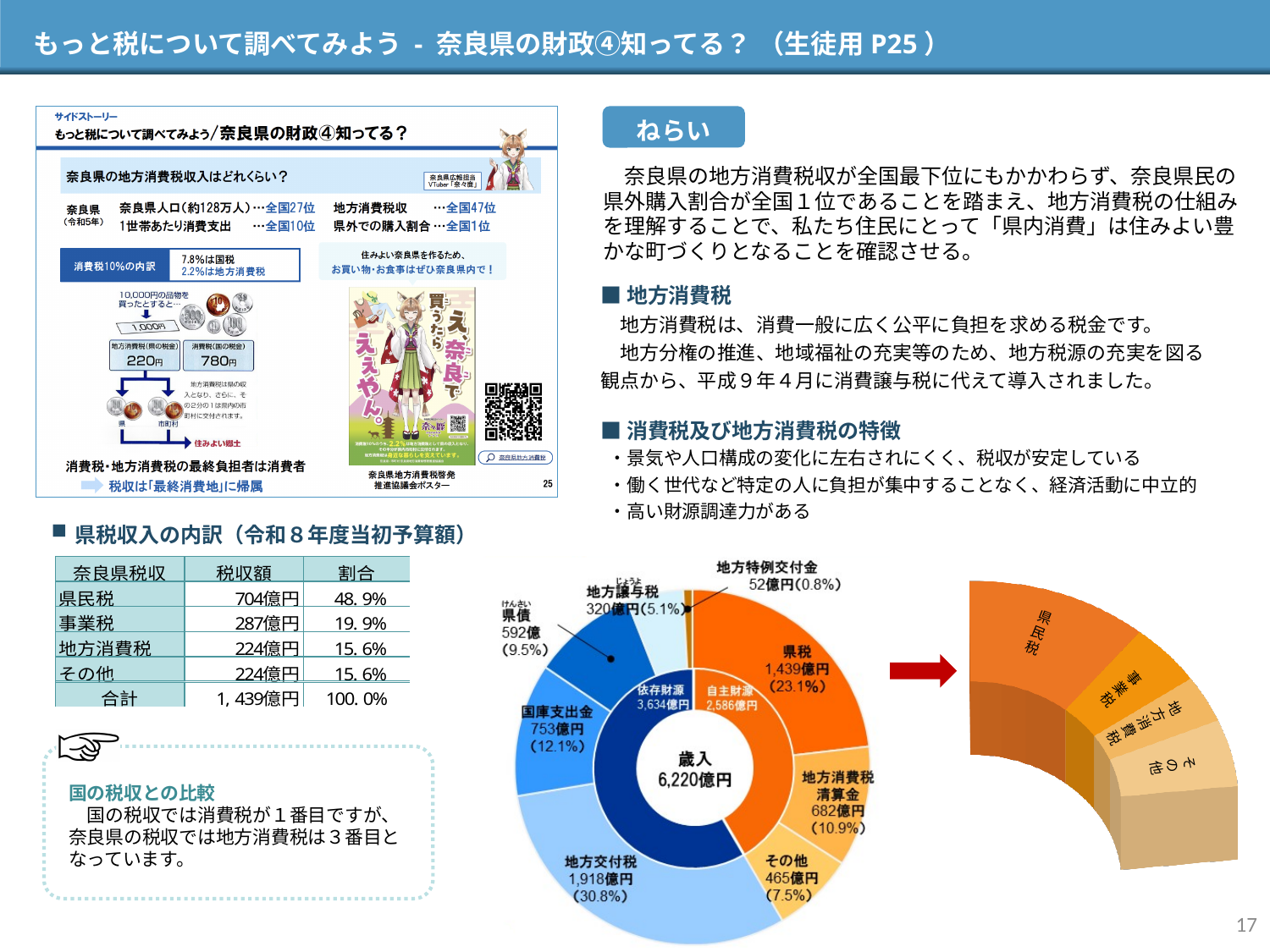
In the 歳入 donut chart, what is the difference between 県税 and 地方消費税清算金? 757億円 In the 歳入 donut chart, what percentage share is shown for 県税? 23.1% In the 歳入 donut chart, what is the value for 国庫支出金? 753億円 How many categories are labelled on the 3D arc chart at the lower right of the slide? 4 In the 歳入 donut chart, which is larger, 国庫支出金 or 県債? 国庫支出金 How many outer segments does the 歳入 donut chart have? 8 In the 歳入 donut chart, what total amount is shown in the centre? 6,220億円 In the 歳入 donut chart, which segment is the largest? 地方交付税 In the 歳入 donut chart, what is the value for 地方交付税? 1,918億円 What kind of chart is the 歳入 chart in the lower centre of the slide? donut chart In the 歳入 donut chart, which segment is the smallest? 地方特例交付金 In the 歳入 donut chart, what is the value shown for 依存財源 in the inner ring? 3,634億円